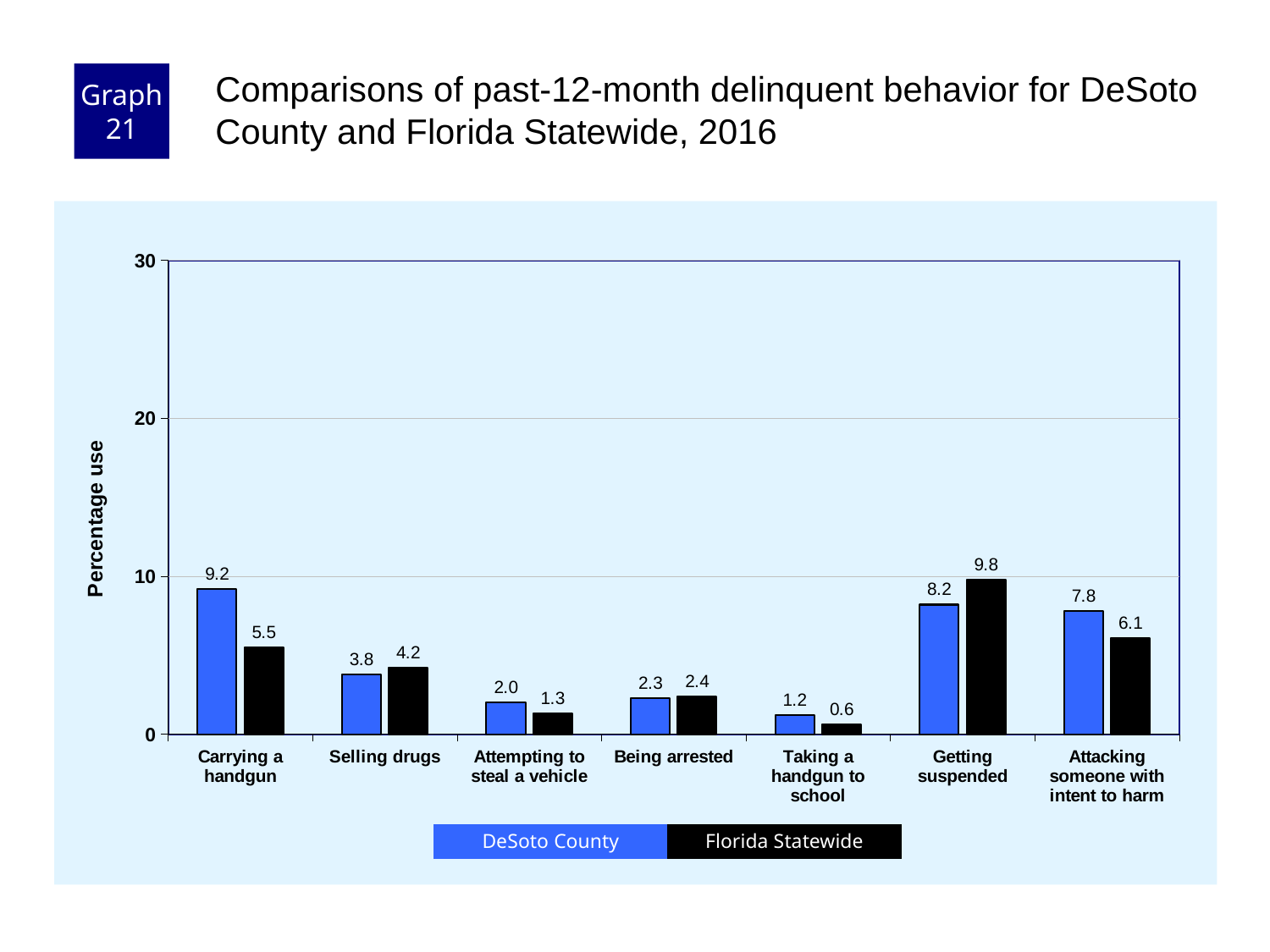
How many categories are shown on the x axis? 7 Which category has the lowest Florida Statewide value? Taking a handgun to school What is the DeSoto County value for Carrying a handgun? 9.2 What is the difference between the DeSoto County and Florida Statewide values for Carrying a handgun? 3.7 What is the difference between the Florida Statewide and DeSoto County values for Getting suspended? 1.6 What is the Florida Statewide value for Getting suspended? 9.8 Is the Florida Statewide value for Getting suspended greater or less than 10? less What is the Florida Statewide value for Taking a handgun to school? 0.6 Which is larger for Attacking someone with intent to harm: DeSoto County or Florida Statewide? DeSoto County How many series does the legend list? 2 What kind of chart is shown on the slide? bar chart Which category has the highest DeSoto County value? Carrying a handgun